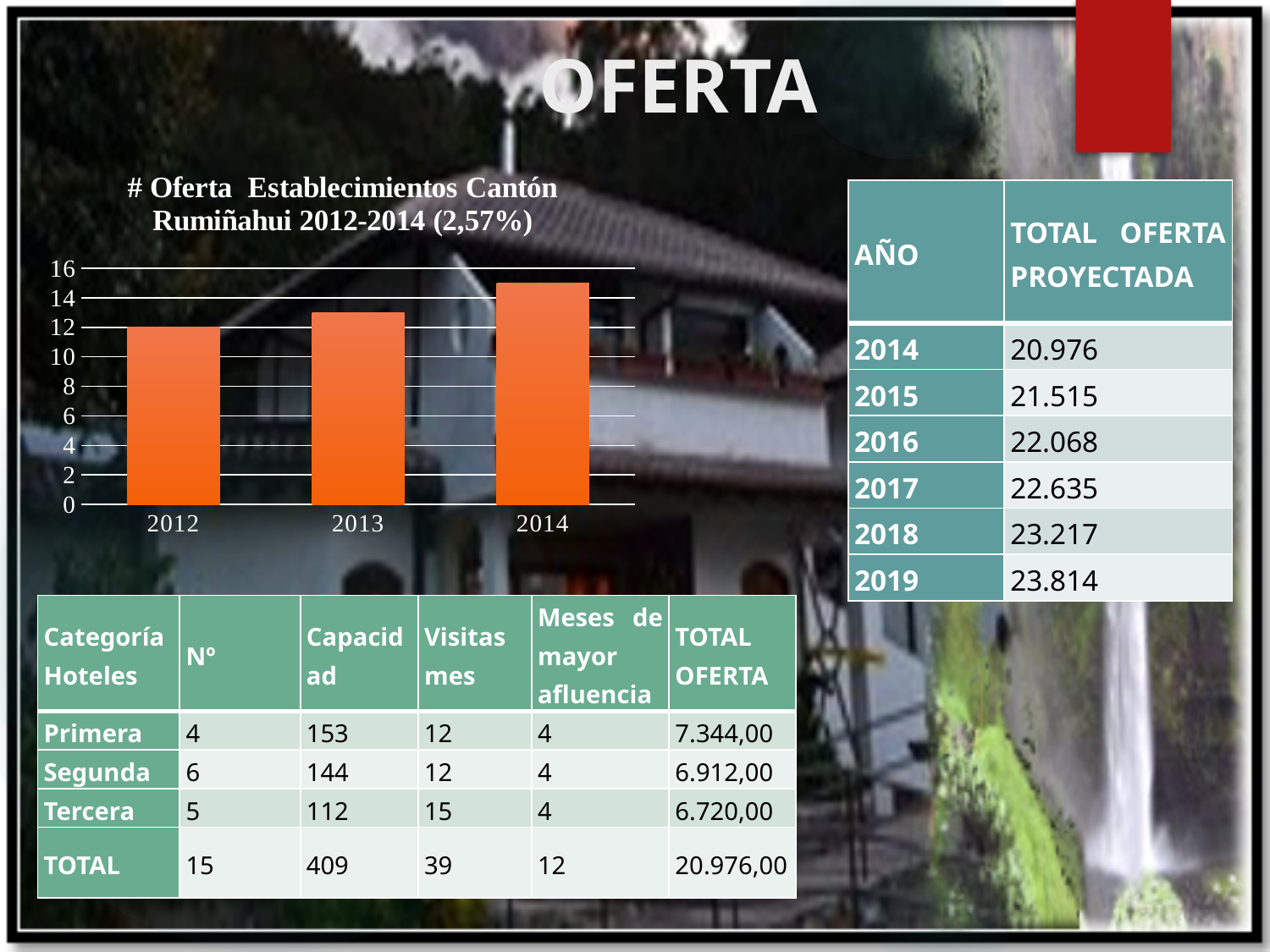
Is the value for 2014 greater or less than 14? greater Which year has the lowest bar in the chart? 2012 What is the value of the bar for 2012? 12 What is the title of the bar chart? # Oferta Establecimientos Cantón Rumiñahui 2012-2014 (2,57%) Do the bar values rise or fall from 2012 to 2014? rise Is the value for 2013 greater or less than 14? less Which bar is taller, 2013 or 2012? 2013 Which year has the highest bar in the chart? 2014 What colour are the bars in the chart? orange Is the value for 2013 greater or less than 12? greater How many years are plotted on the x axis of the bar chart? 3 What kind of chart is shown on the slide? bar chart